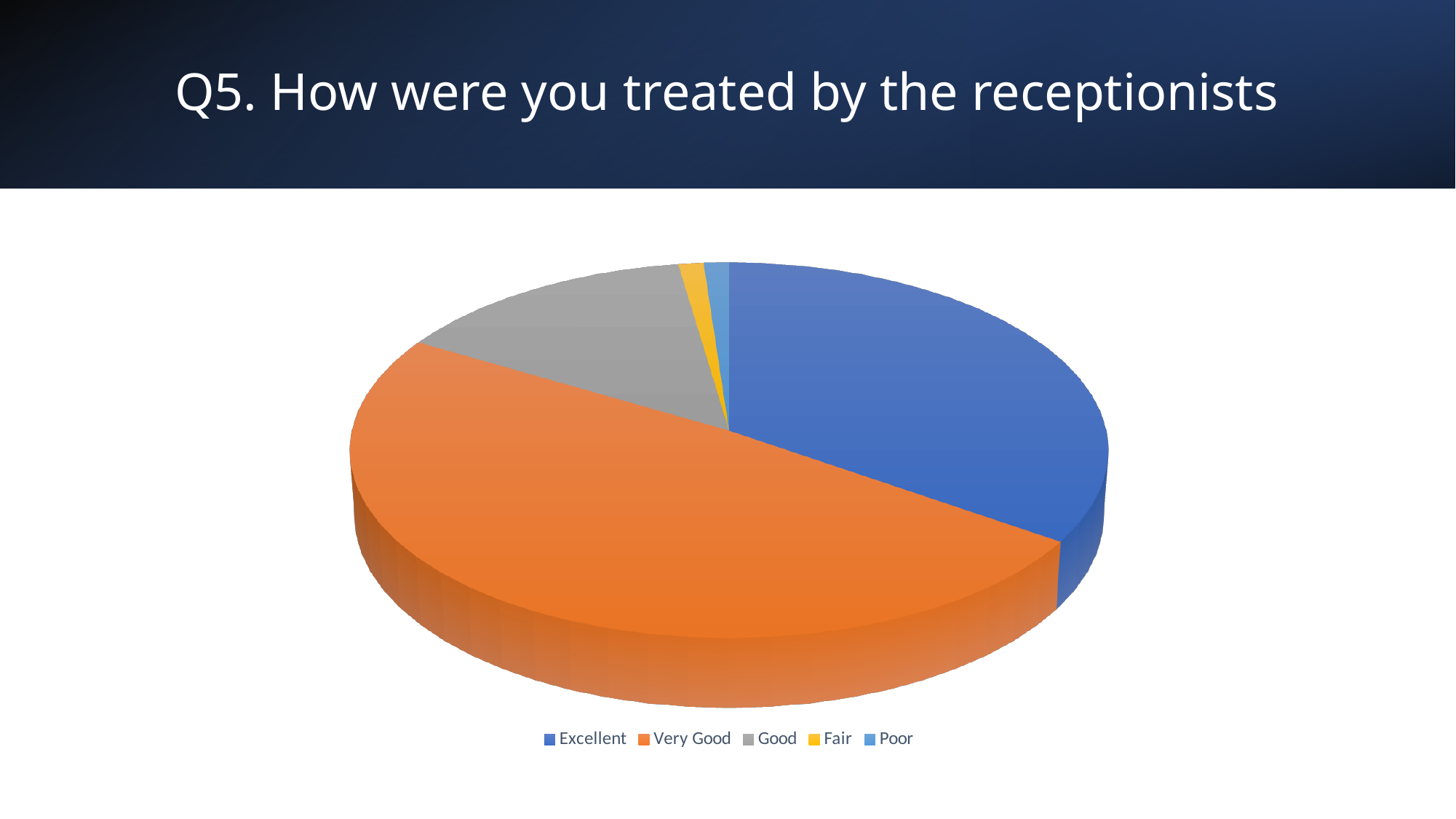
Which slice is larger, Very Good or Excellent? Very Good Which category has the second-largest slice of the pie? Excellent What kind of chart is shown on the slide? Pie chart Which slice is larger, Good or Poor? Good Which colour represents the Very Good category in the pie chart? Orange Which category has the largest slice of the pie? Very Good Which slice is larger, Good or Fair? Good What is the title of the slide containing the pie chart? Q5. How were you treated by the receptionists How many categories does the pie chart show? 5